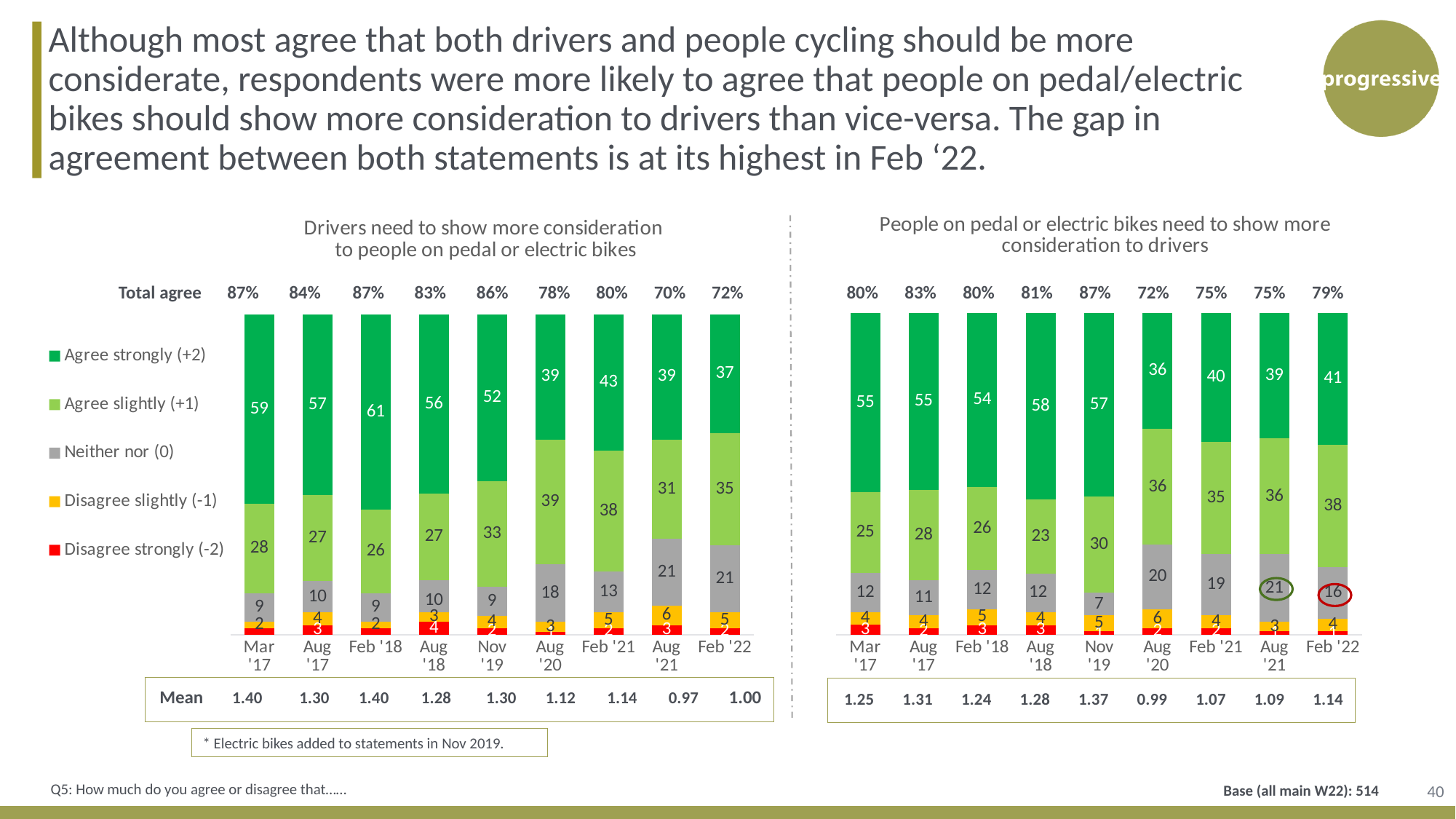
In the right chart (People on pedal or electric bikes need to show more consideration to drivers), what is the Agree slightly value for Feb '22? 38 In the right chart, what is the Total agree percentage for Aug '20? 72% In the right chart, which period has the highest Total agree percentage? Nov '19 In the left chart (Drivers need to show more consideration to people on pedal or electric bikes), what is the Agree strongly value for Feb '18? 61 What type of chart is used on this slide? Stacked bar chart How many time periods are shown on the x axis of the left chart? 9 In the left chart, what is the difference between the Agree strongly values for Mar '17 and Feb '22? 22 In the right chart, is the Neither nor value larger for Aug '21 or for Feb '22? Aug '21 In the left chart, which period has the lowest Total agree percentage? Aug '21 In the right chart, what is the difference between the Agree strongly values for Aug '18 and Aug '20? 22 How many series does the legend list? 5 In the left chart, what is the Mean value for Aug '21? 0.97